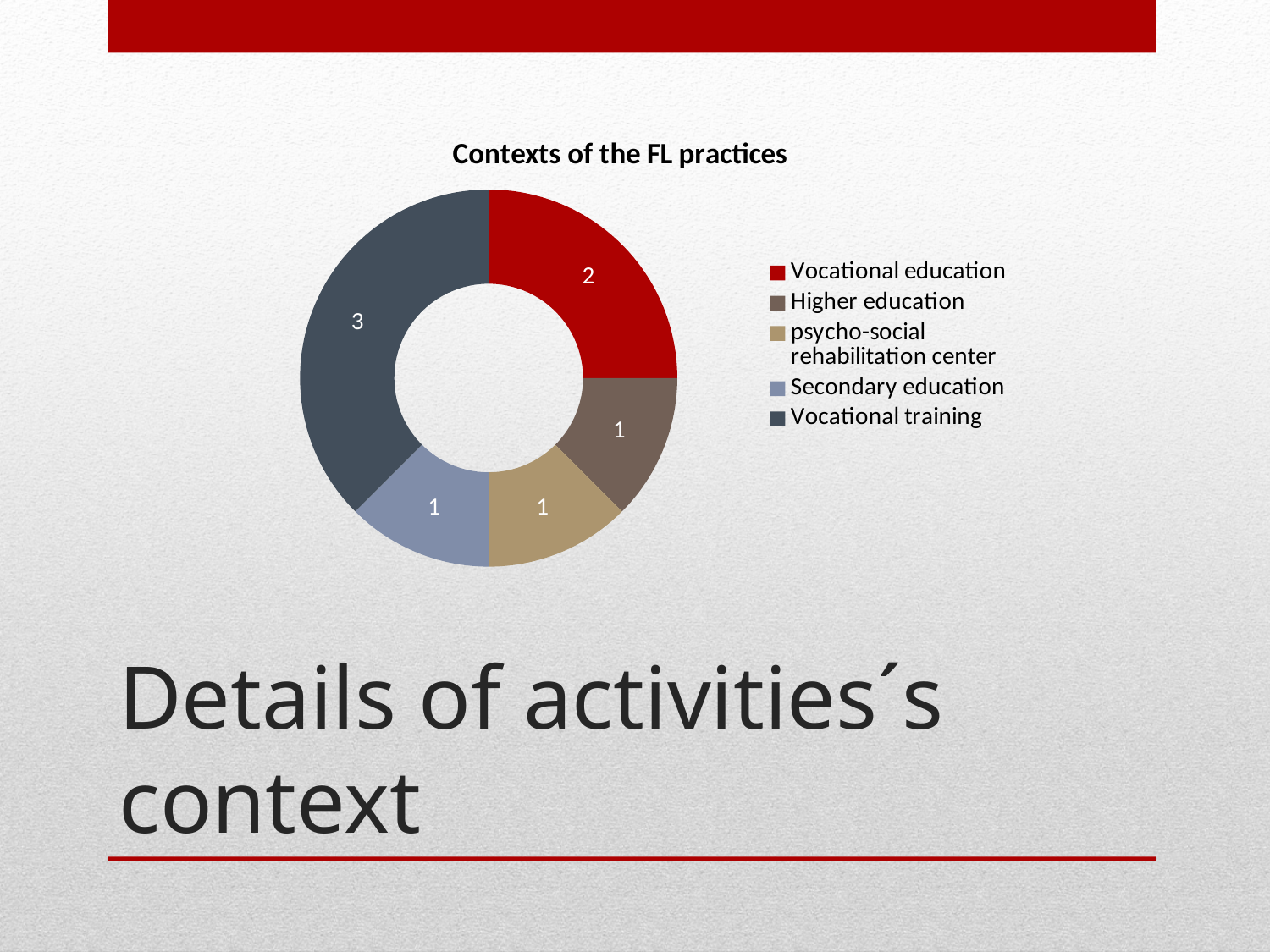
Which category is shown in red in the 'Contexts of the FL practices' chart? Vocational education Which category has the largest slice in the 'Contexts of the FL practices' chart? Vocational training How many categories are shown in the 'Contexts of the FL practices' chart? 5 What is the value for Higher education in the 'Contexts of the FL practices' chart? 1 What is the title of the chart on the slide? Contexts of the FL practices What is the value for Vocational education in the 'Contexts of the FL practices' chart? 2 What kind of chart is shown on the slide? Doughnut (pie) chart What is the value for Vocational training in the 'Contexts of the FL practices' chart? 3 What is the total of all the values in the 'Contexts of the FL practices' chart? 8 What is the difference between the values for Vocational training and Vocational education? 1 What share of the total does Vocational training represent in the 'Contexts of the FL practices' chart? 37.5% Which is larger, the value for Vocational education or the value for Secondary education? Vocational education